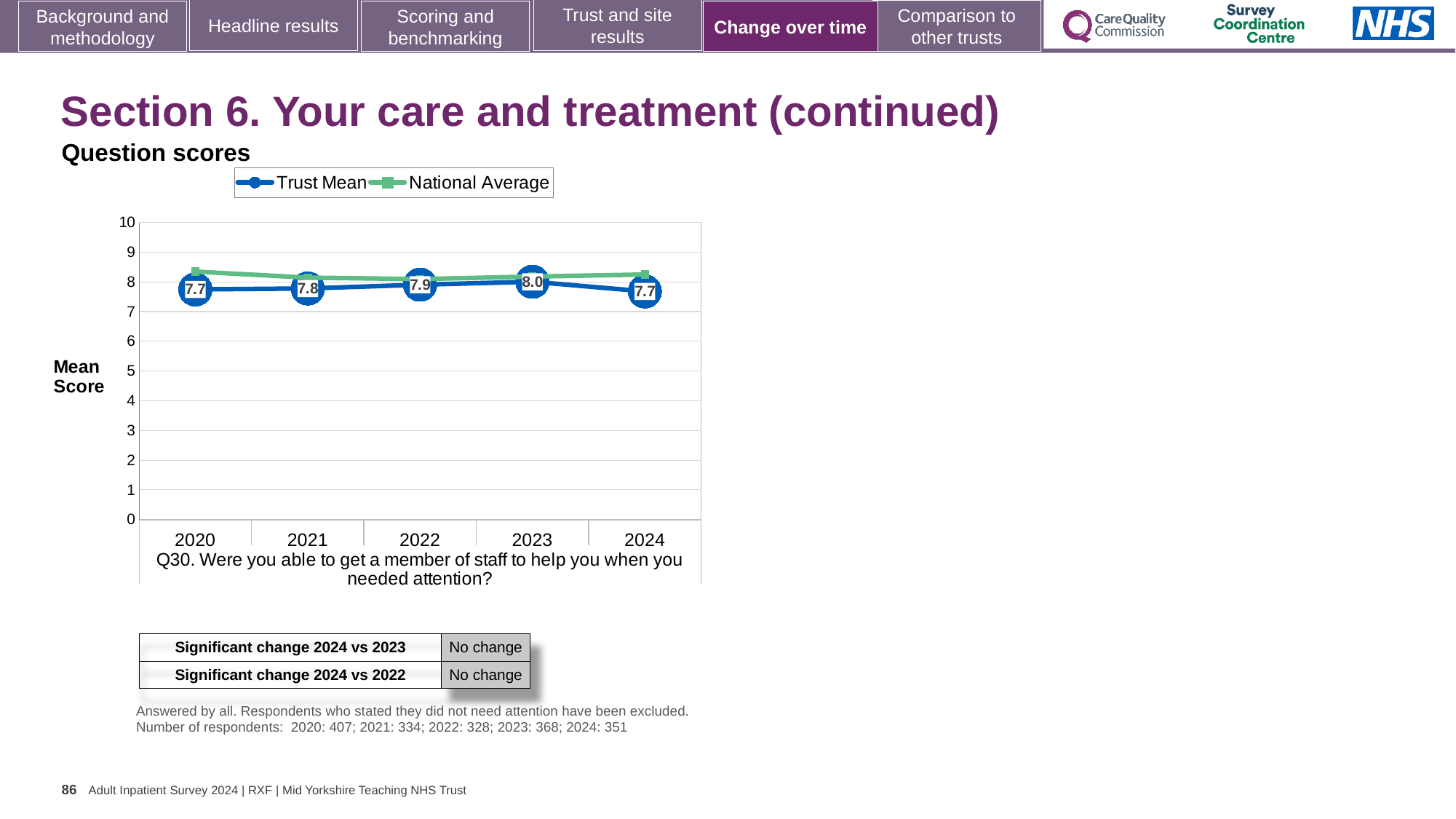
In which year is the Trust Mean score highest? 2023 Which year has the larger Trust Mean score, 2021 or 2022? 2022 How many series does the legend list? 2 What kind of chart is shown on the slide? line chart How many years are plotted on the x axis? 5 What is the difference between the Trust Mean scores for 2023 and 2024? 0.3 What is the Trust Mean score for 2023? 8.0 Does the Trust Mean score rise or fall from 2020 to 2023? rise Is the National Average value for 2020 greater or less than 8? greater What is the label on the y axis of the chart? Mean Score What is the Trust Mean score for 2022? 7.9 What is the Trust Mean score for 2020? 7.7